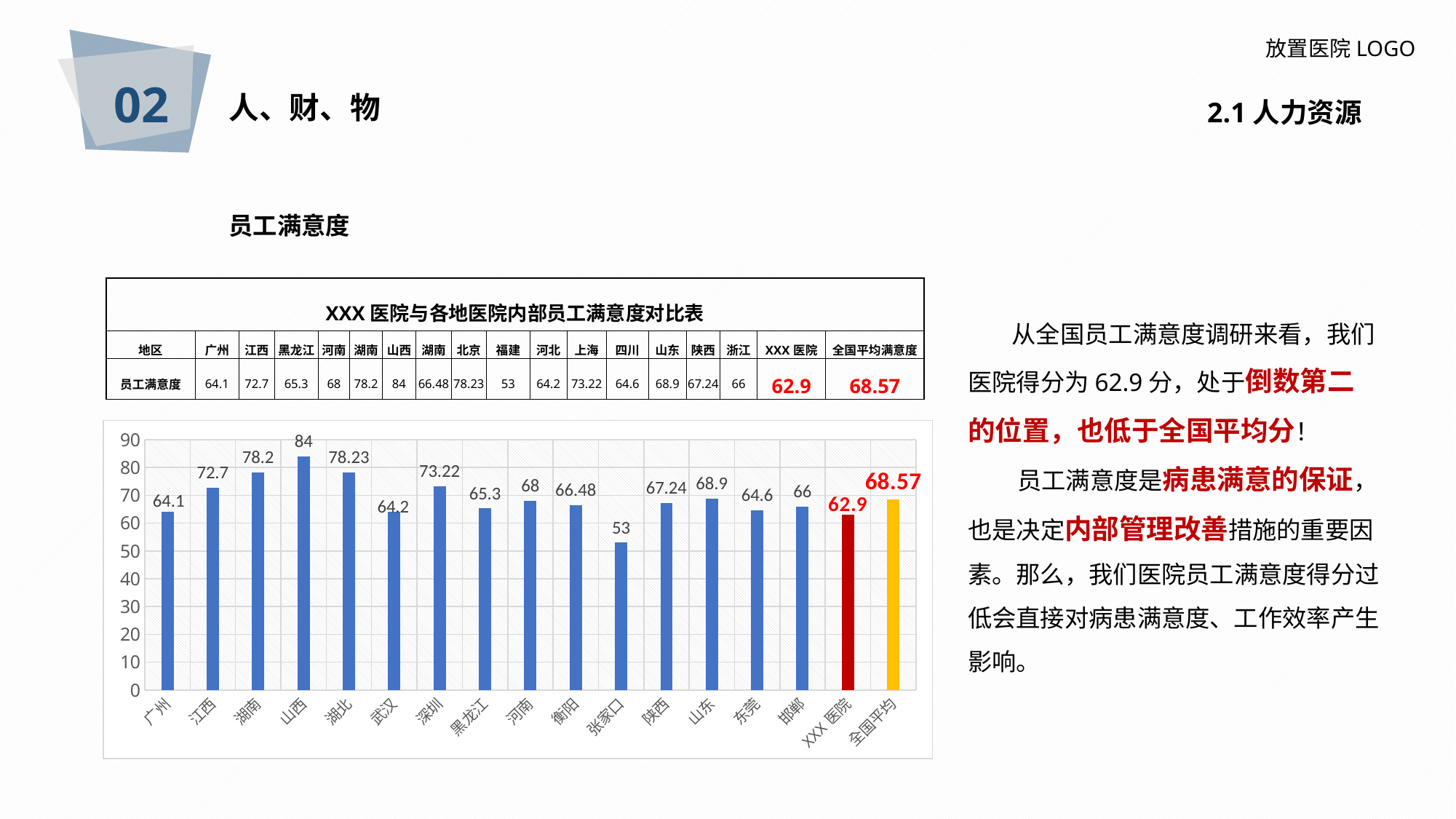
Which category has the highest value in the bar chart? 山西 Which category has the lowest value in the bar chart? 张家口 Is the value for 张家口 in the bar chart greater or less than 60? less Which is larger in the bar chart, the value for 湖南 or the value for 江西? 湖南 What is the difference between the values for 山西 and 张家口 in the bar chart? 31 What is the value for XXX 医院 in the bar chart? 62.9 How many bars are plotted in the bar chart? 17 What is the difference between the 全国平均 value and the XXX 医院 value in the bar chart? 5.67 What kind of chart is shown on the slide? bar chart What is the value for 全国平均 in the bar chart? 68.57 What is the value for 深圳 in the bar chart? 73.22 What colour is the bar for XXX 医院 in the bar chart? red